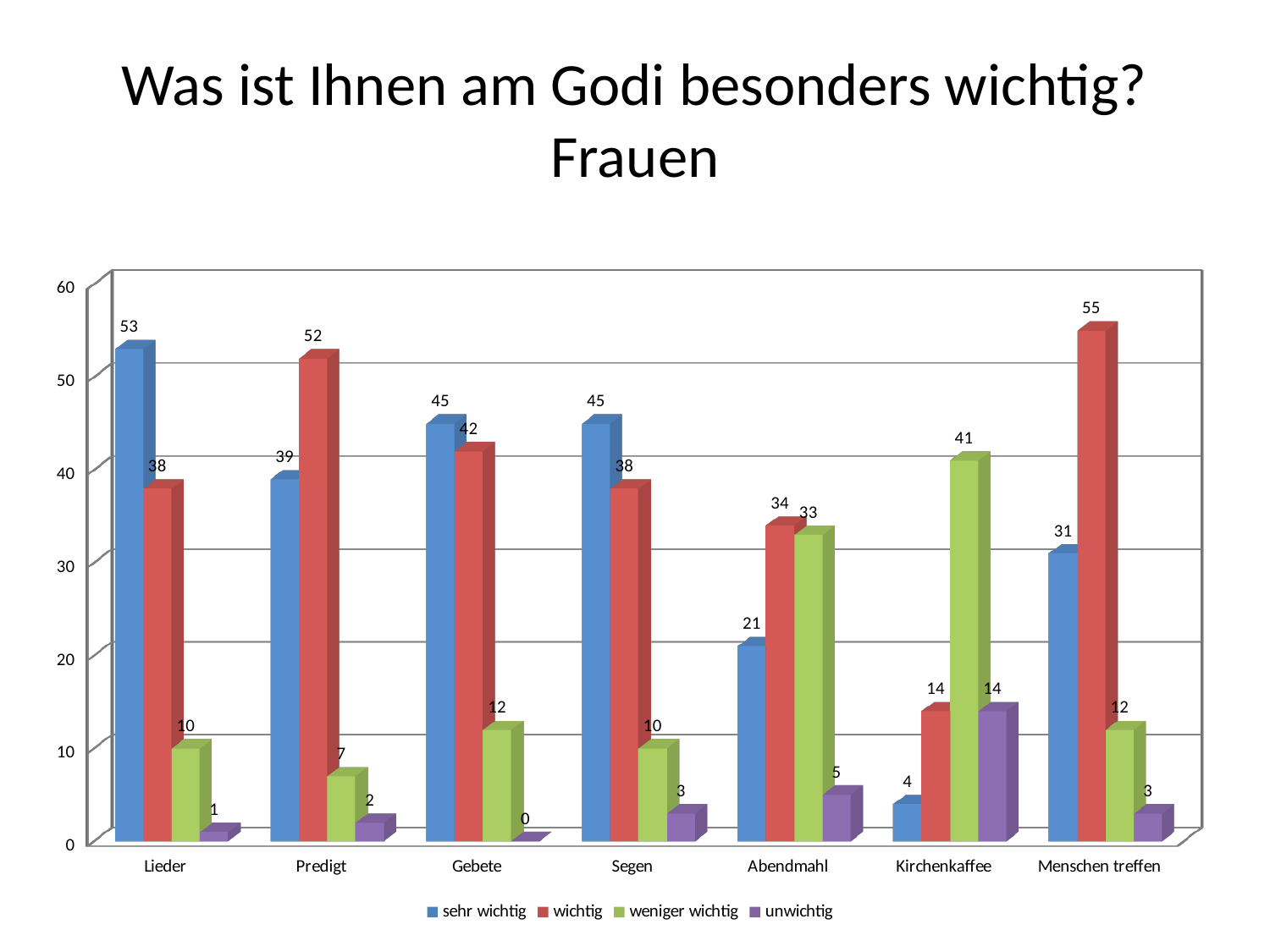
What is the value for "sehr wichtig" for Lieder? 53 How many series does the legend list? 4 What is the value for "weniger wichtig" for Kirchenkaffee? 41 What is the difference between the "wichtig" value for Predigt and the "wichtig" value for Lieder? 14 For Abendmahl, which is larger: the "wichtig" value or the "sehr wichtig" value? wichtig What is the value for "unwichtig" for Gebete? 0 What kind of chart is shown on the slide? Bar chart Which category has the highest value for "sehr wichtig"? Lieder What is the value for "wichtig" for Menschen treffen? 55 How many categories are shown on the x axis? 7 Which series is shown in green in the legend? weniger wichtig Which category has the lowest value for "sehr wichtig"? Kirchenkaffee